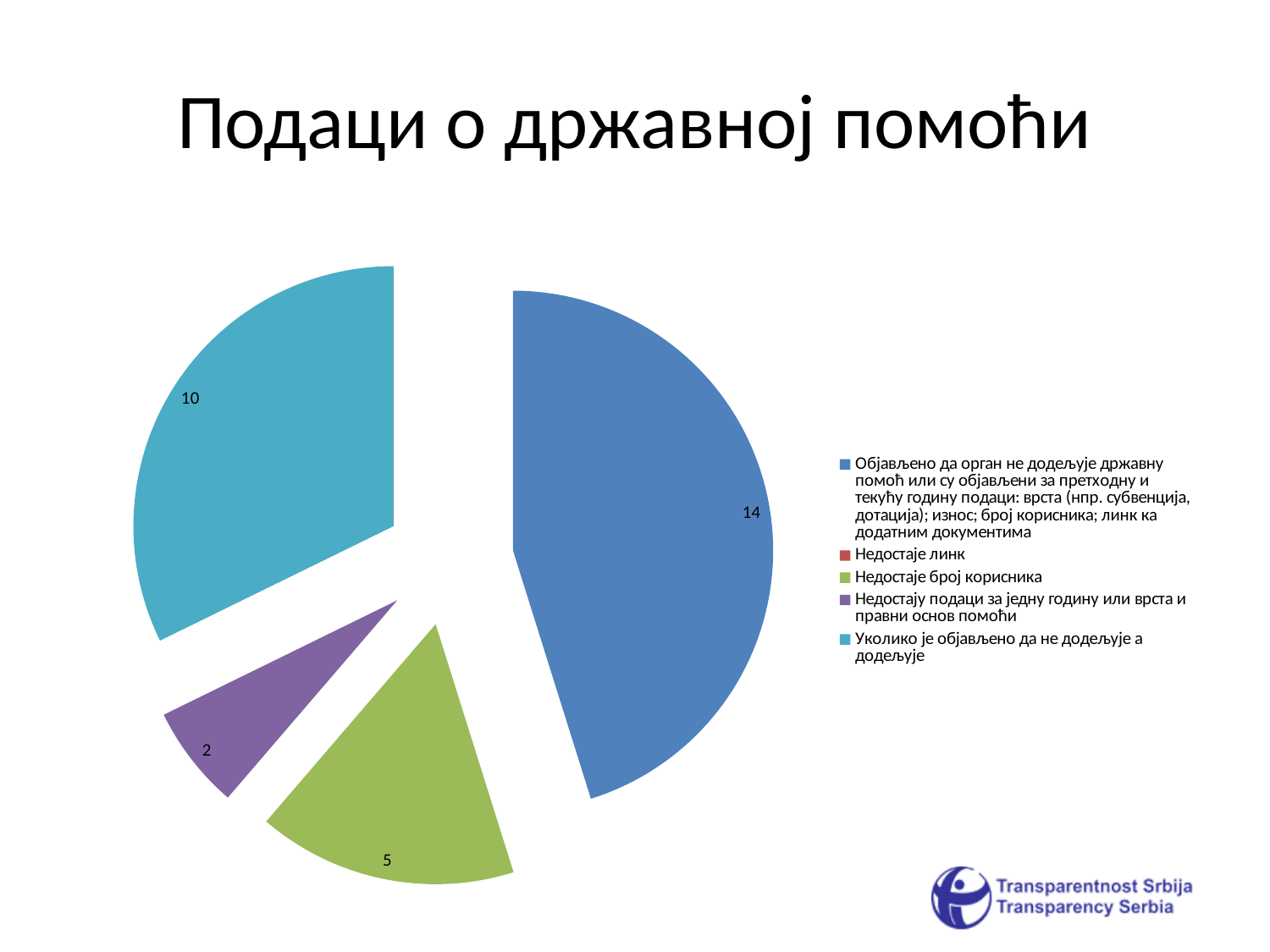
What is the difference between the largest slice (14) and the slice for "Уколико је објављено да не додељује а додељује"? 4 What kind of chart is shown on the slide? pie chart How many slices with data labels are visible in the pie chart? 4 Which of the labeled slices has the smallest value? Недостају подаци за једну годину или врста и правни основ помоћи Which is larger: the slice for "Недостаје број корисника" or the slice for "Недостају подаци за једну годину или врста и правни основ помоћи"? Недостаје број корисника What is the value of the blue slice, the first legend entry ("Објављено да орган не додељује државну помоћ...")? 14 Which legend category has the largest slice in the pie chart? Објављено да орган не додељује државну помоћ или су објављени за претходну и текућу годину подаци What is the value of the slice for "Недостаје број корисника"? 5 How many entries does the legend of the pie chart list? 5 What is the value of the slice for "Уколико је објављено да не додељује а додељује"? 10 What is the value of the slice for "Недостају подаци за једну годину или врста и правни основ помоћи"? 2 What is the difference between the slice for "Уколико је објављено да не додељује а додељује" and the slice for "Недостаје број корисника"? 5